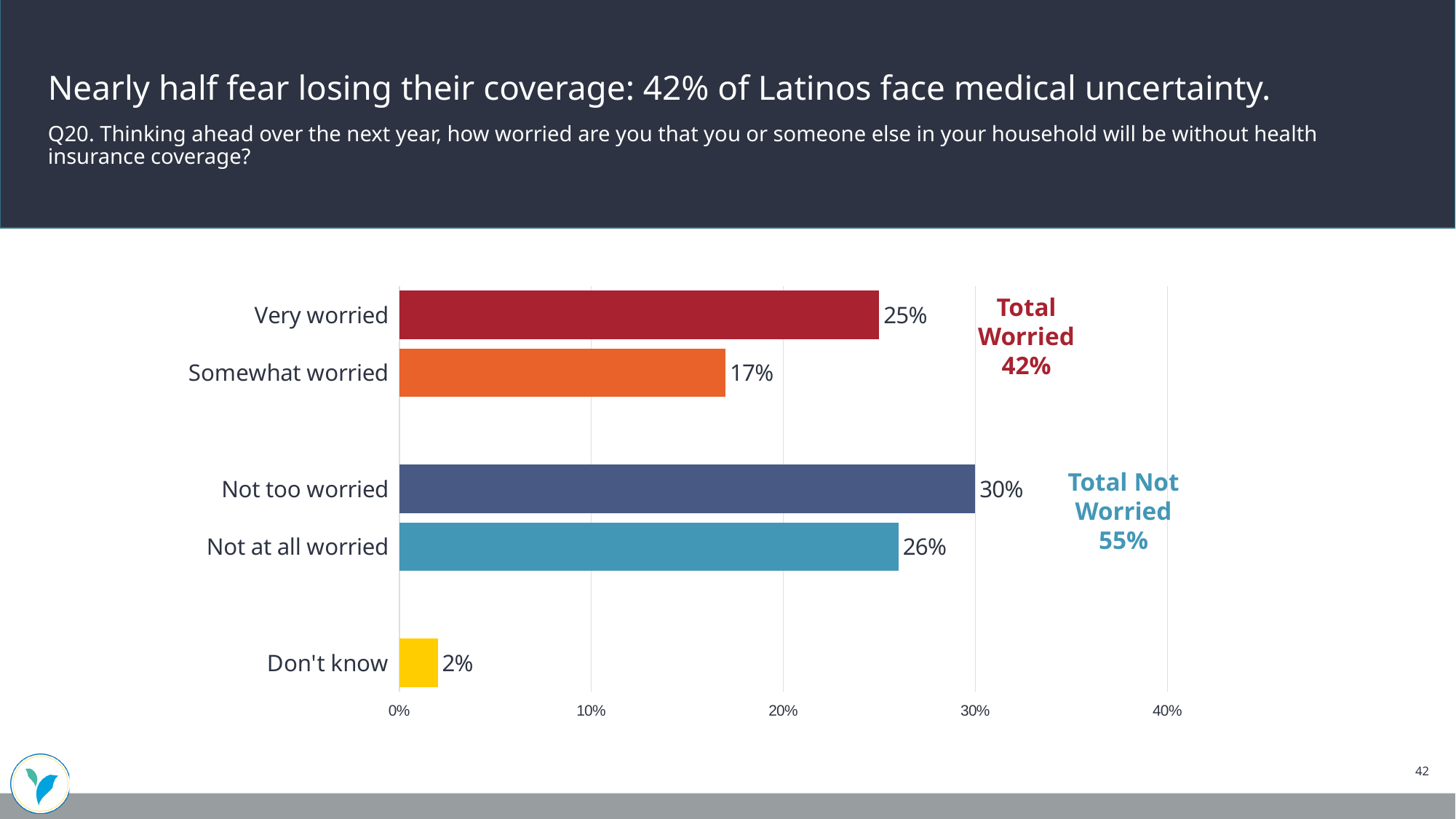
What is the Total Not Worried percentage shown on the chart? 55% What percentage of respondents are very worried? 25% What kind of chart is shown on the slide? Bar chart Which response category has the lowest percentage? Don't know What percentage of respondents are somewhat worried? 17% What percentage of respondents are not too worried? 30% What is the difference in percentage points between 'Not too worried' and 'Somewhat worried'? 13 What percentage of respondents answered 'Don't know'? 2% Which is larger, the percentage for 'Not at all worried' or for 'Very worried'? Not at all worried What is the Total Worried percentage shown on the chart? 42% How many response categories are shown in the chart? 5 Which response category has the highest percentage? Not too worried